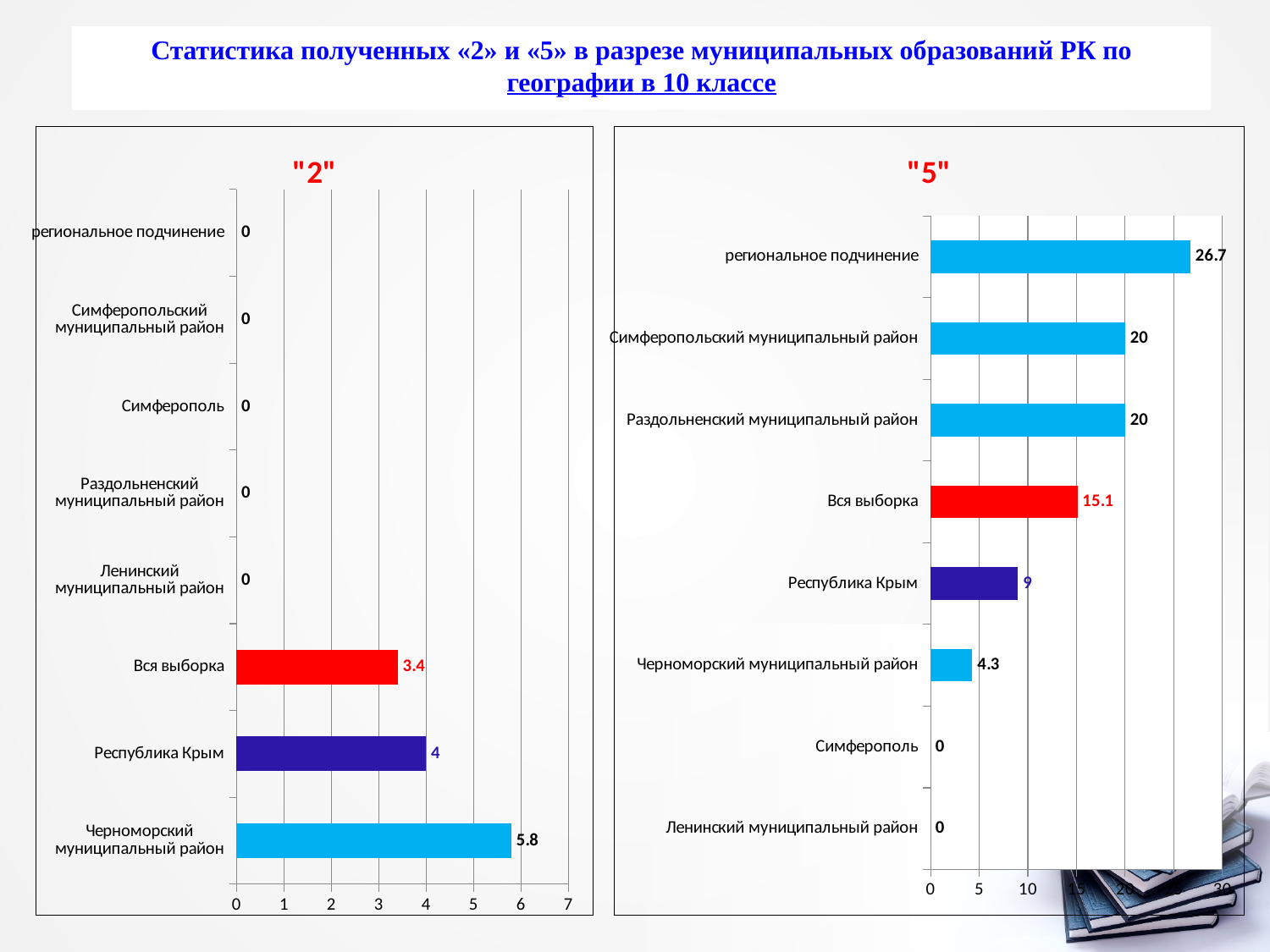
In the chart titled "5", which is larger: the value for Вся выборка or the value for Черноморский муниципальный район? Вся выборка In the chart titled "5", which category has the highest value? региональное подчинение In the chart titled "5", what is the difference between the values for региональное подчинение and Вся выборка? 11.6 In the chart titled "5", what colour is the bar for Вся выборка? Red In the chart titled "2", how many categories are shown? 8 In the chart titled "5", what is the value for региональное подчинение? 26.7 In the chart titled "2", which category has the highest value? Черноморский муниципальный район In the chart titled "2", what is the difference between the values for Черноморский муниципальный район and Республика Крым? 1.8 What kind of chart is the chart titled "5"? Bar chart In the chart titled "5", what is the value for Республика Крым? 9 In the chart titled "2", what is the value for Вся выборка? 3.4 In the chart titled "2", what is the value for Черноморский муниципальный район? 5.8